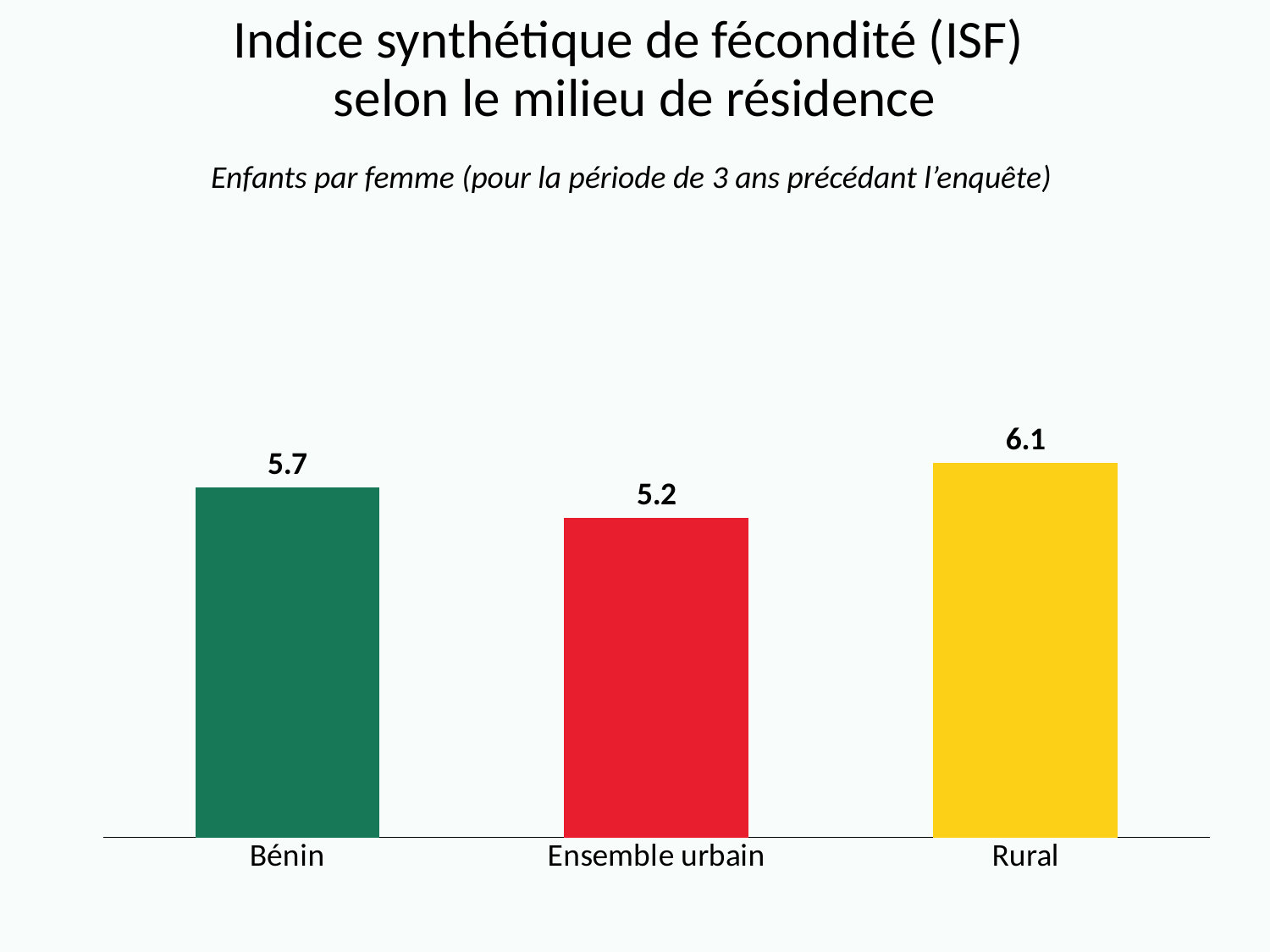
Which is larger, the value for Bénin or the value for Rural? Rural Which category has the lowest value? Ensemble urbain How many categories are shown on the chart? 3 What is the value for Bénin? 5.7 What is the value for Ensemble urbain? 5.2 What is the title of the chart? Indice synthétique de fécondité (ISF) selon le milieu de résidence What is the difference between the values for Rural and Ensemble urbain? 0.9 What is the difference between the values for Bénin and Ensemble urbain? 0.5 What is the value for Rural? 6.1 What kind of chart is shown on the slide? Bar chart Which category has the highest value? Rural What colour is the bar for Rural? Yellow